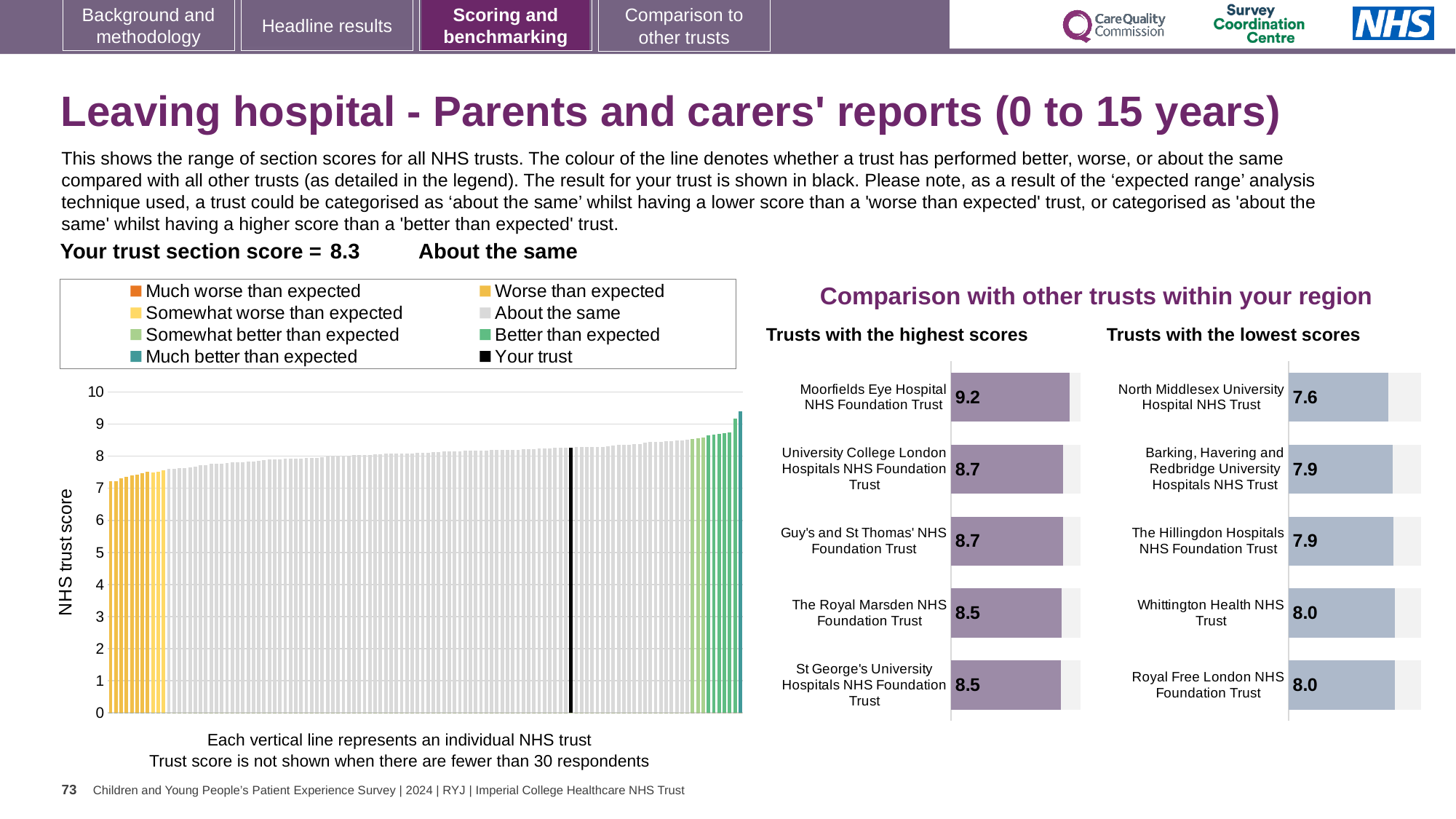
In the 'Trusts with the lowest scores' chart, which has the higher score: Whittington Health NHS Trust or The Hillingdon Hospitals NHS Foundation Trust? Whittington Health NHS Trust How many entries does the legend above the large 'NHS trust score' chart list? 8 What kind of chart is the large 'NHS trust score' chart on the left of the slide? bar chart In the large 'NHS trust score' chart on the left, is the value of the tallest bar greater or less than 9? greater How many trusts are shown in the 'Trusts with the highest scores' chart? 5 In the large 'NHS trust score' chart on the left, do the bar values rise or fall from left to right? rise In the 'Trusts with the highest scores' chart, which trust has the highest score? Moorfields Eye Hospital NHS Foundation Trust In the 'Trusts with the highest scores' chart, what is the difference between the scores of Moorfields Eye Hospital NHS Foundation Trust and The Royal Marsden NHS Foundation Trust? 0.7 In the 'Trusts with the highest scores' chart, what is the score for Moorfields Eye Hospital NHS Foundation Trust? 9.2 In the 'Trusts with the lowest scores' chart, which trust has the lowest score? North Middlesex University Hospital NHS Trust In the 'Trusts with the lowest scores' chart, what is the score for North Middlesex University Hospital NHS Trust? 7.6 In the 'Trusts with the lowest scores' chart, what is the difference between the scores of Royal Free London NHS Foundation Trust and North Middlesex University Hospital NHS Trust? 0.4